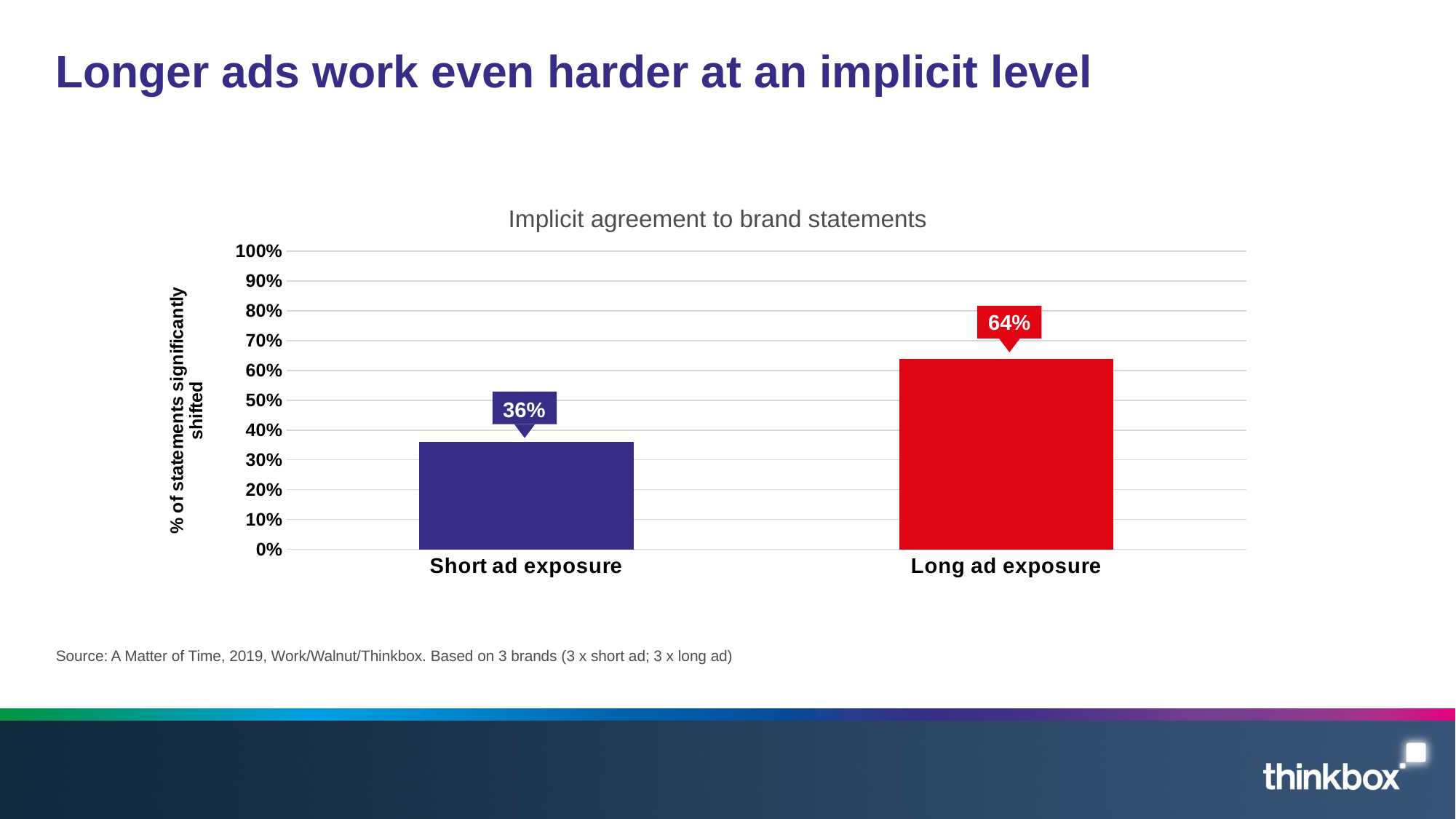
What is the value for Long ad exposure? 64% What is the label of the vertical axis? % of statements significantly shifted Is the value for Long ad exposure greater or less than 50%? greater Which category has the lowest value? Short ad exposure What is the title of the chart? Implicit agreement to brand statements How many categories are shown on the x axis? 2 What is the value for Short ad exposure? 36% What is the difference between the values for Long ad exposure and Short ad exposure? 28% Which is larger, the value for Short ad exposure or Long ad exposure? Long ad exposure Which category has the highest value? Long ad exposure What kind of chart is shown on the slide? Bar chart Is the value for Short ad exposure greater or less than 40%? less